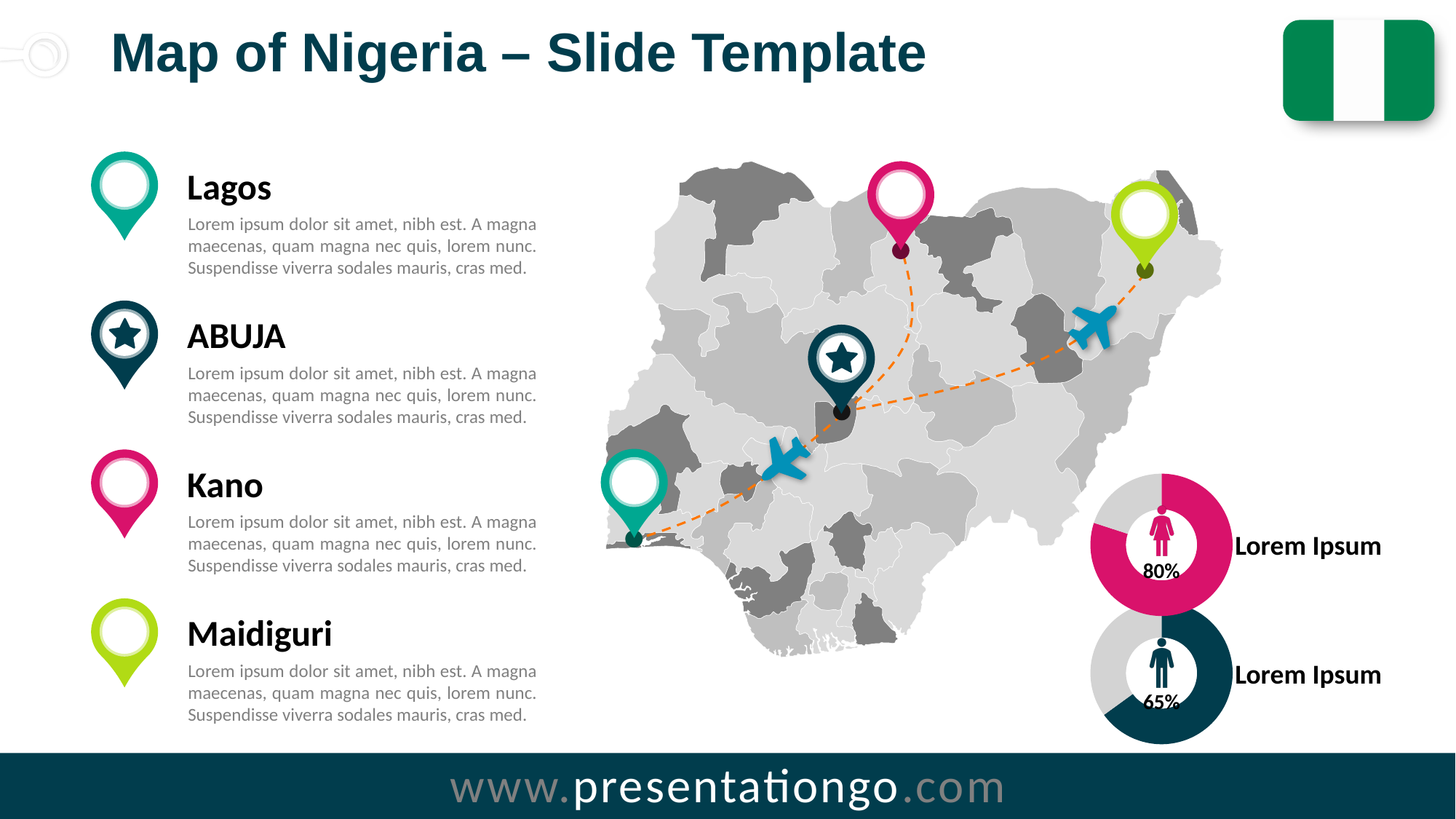
What is the difference between the percentages in the top and bottom donut charts? 15 percentage points Is the value in the bottom donut chart greater or less than 50%? greater Which donut chart shows the larger percentage, the top one or the bottom one? The top one (80%) What colour is the filled portion of the top donut chart? Pink (magenta) What label appears next to each of the two donut charts? Lorem Ipsum How many donut charts are on the slide? 2 What kind of chart is used to display the 80% and 65% values? Donut (pie) chart What share of the bottom donut chart is left unfilled (grey)? 35% Which donut chart shows the lowest percentage? The bottom one (65%) What percentage is shown in the top donut chart (with the female icon)? 80% What percentage is shown in the bottom donut chart (with the male icon)? 65% Is the value in the top donut chart greater or less than 50%? greater